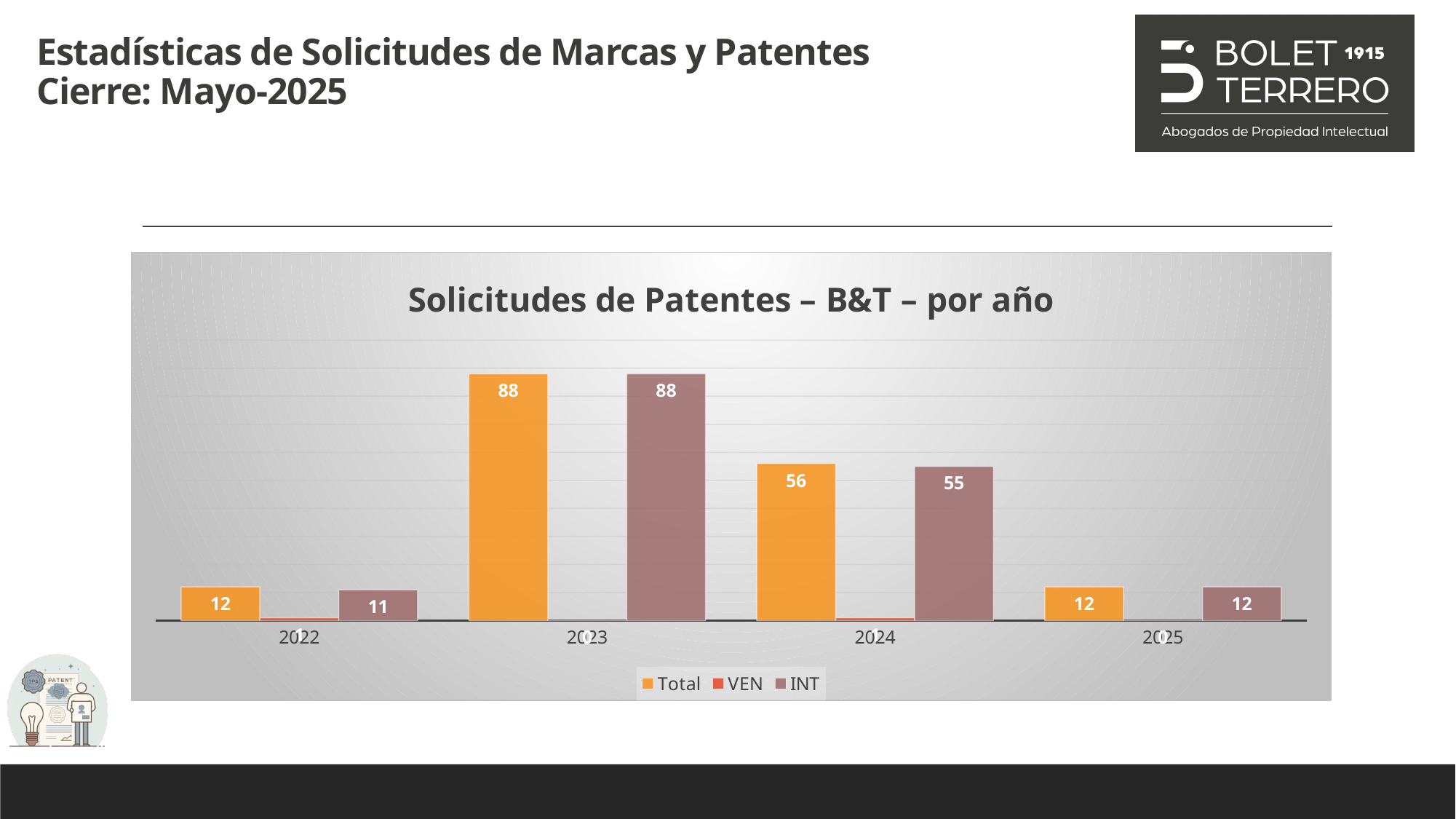
What is the Total value for 2023? 88 Which year has the highest Total value? 2023 Do the Total values rise or fall from 2023 to 2025? Fall What is the difference between the Total values for 2023 and 2024? 32 How many years are shown on the x axis? 4 Which is larger in 2024, the Total value or the INT value? Total What is the INT value for 2024? 55 How many series does the legend list? 3 What is the INT value for 2022? 11 Which year has the lowest INT value? 2022 What kind of chart is shown? Bar chart What is the title of the chart? Solicitudes de Patentes – B&T – por año